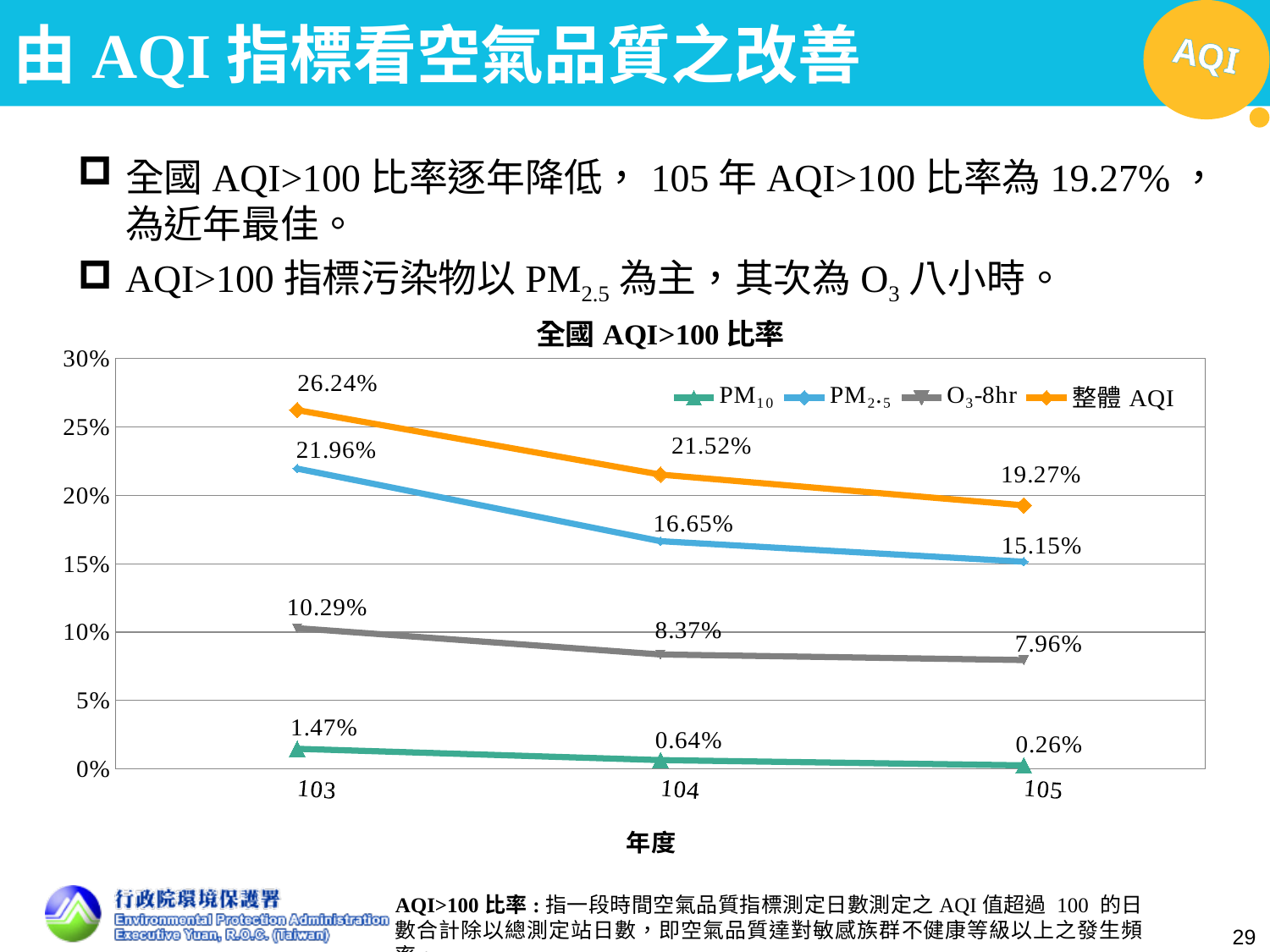
What type of chart is shown on the slide? line chart What is the 整體 AQI value for year 105? 19.27% What is the difference between the 整體 AQI values for years 103 and 105? 6.97% How many series does the legend list? 4 What is the PM10 value for year 105? 0.26% How many years are shown on the x axis? 3 Which is larger in year 105: the PM2.5 value or the O3-8hr value? PM2.5 Does the PM2.5 series rise or fall from year 103 to year 105? fall What is the O3-8hr value for year 103? 10.29% What is the PM2.5 value for year 104? 16.65% In which year is the 整體 AQI value highest? 103 Which series has the lowest value in year 104? PM10